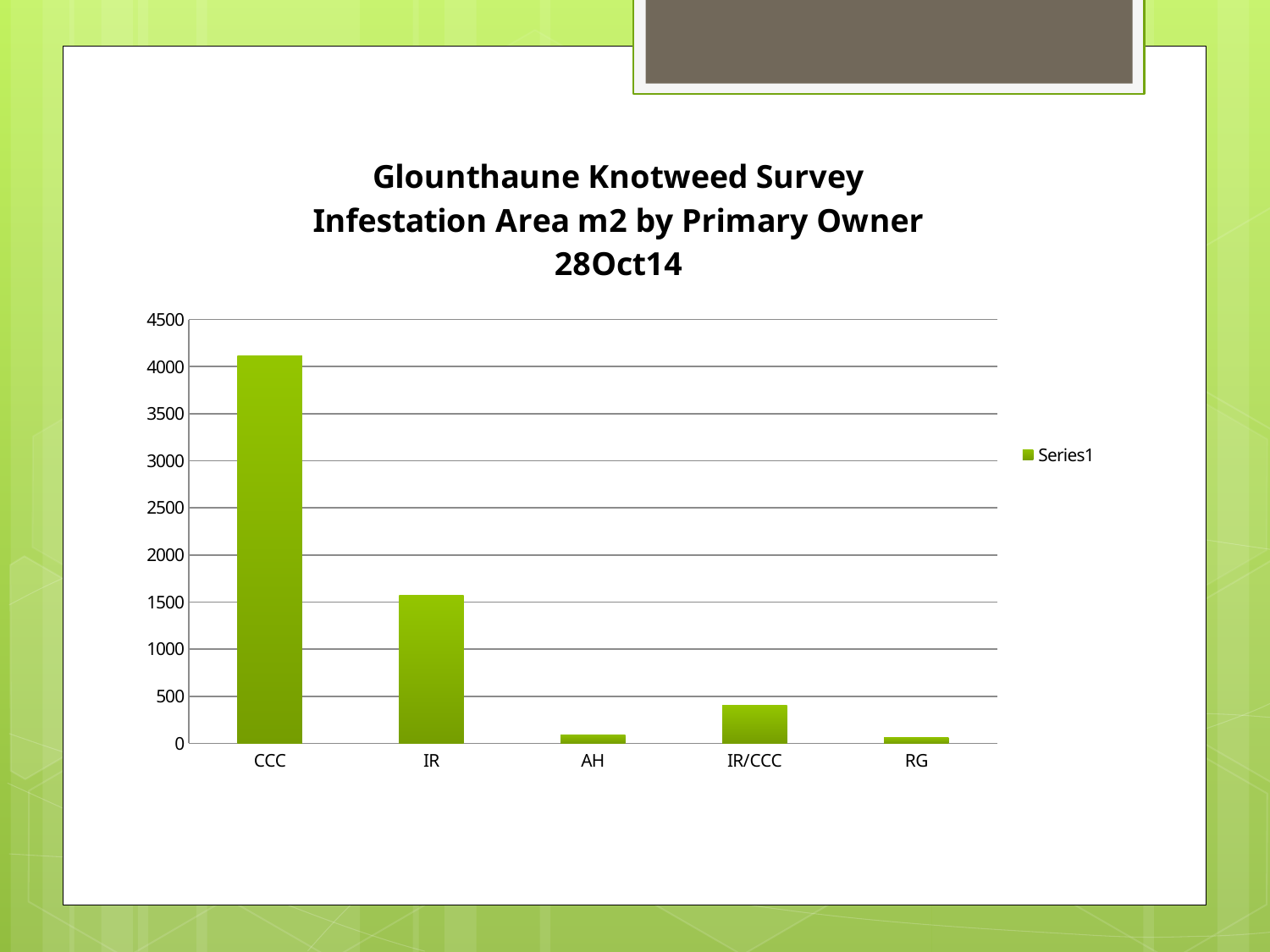
Is the value for IR greater or less than 2000? less Which has a larger infestation area, AH or IR/CCC? IR/CCC Which primary owner has the highest infestation area? CCC Which has a larger infestation area, IR or IR/CCC? IR Is the value for CCC greater or less than 4000? greater How many primary owner categories are shown on the x axis? 5 Which primary owner has the lowest infestation area? RG How many series does the legend list? 1 Is the value for AH greater or less than 500? less What type of chart is shown on the slide? bar chart What is the name of the series shown in the legend? Series1